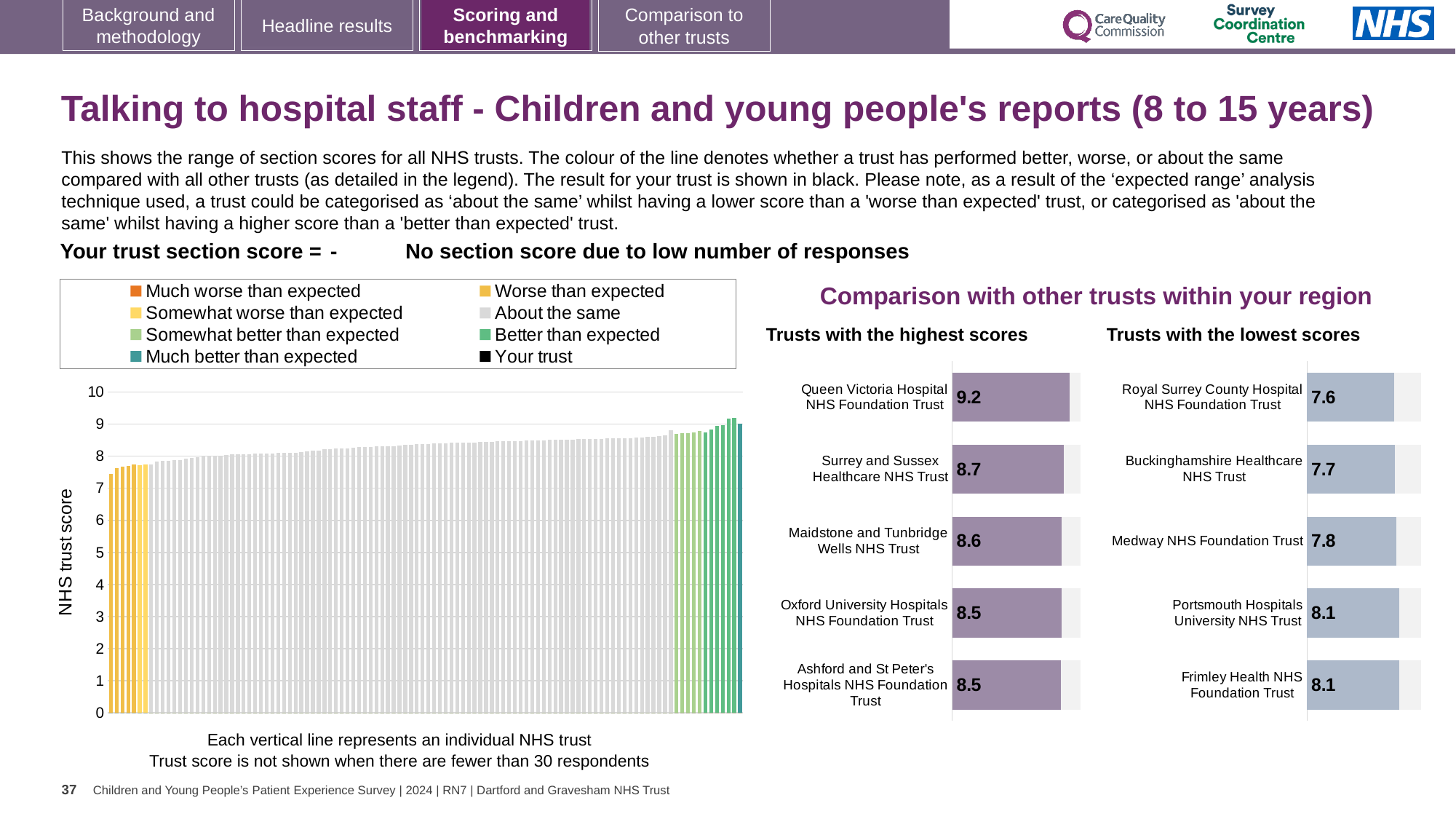
In the large 'NHS trust score' chart, is the value of the leftmost bar greater or less than 8? less In the 'Trusts with the highest scores' chart, what is the score for Queen Victoria Hospital NHS Foundation Trust? 9.2 How many trusts are listed in the 'Trusts with the highest scores' chart? 5 In the 'Trusts with the lowest scores' chart, which has the larger score: Buckinghamshire Healthcare NHS Trust or Portsmouth Hospitals University NHS Trust? Portsmouth Hospitals University NHS Trust In the 'Trusts with the lowest scores' chart, what is the score for Medway NHS Foundation Trust? 7.8 What kind of chart is the large chart labelled 'NHS trust score'? Bar chart In the 'Trusts with the highest scores' chart, which trust has the highest score? Queen Victoria Hospital NHS Foundation Trust In the 'Trusts with the lowest scores' chart, what is the score for Frimley Health NHS Foundation Trust? 8.1 In the 'Trusts with the lowest scores' chart, which trust has the lowest score? Royal Surrey County Hospital NHS Foundation Trust In the large 'NHS trust score' chart, do the bar values rise or fall from left to right? Rise How many entries does the legend of the large 'NHS trust score' chart list? 8 In the 'Trusts with the highest scores' chart, what is the difference between the scores of Queen Victoria Hospital NHS Foundation Trust and Surrey and Sussex Healthcare NHS Trust? 0.5